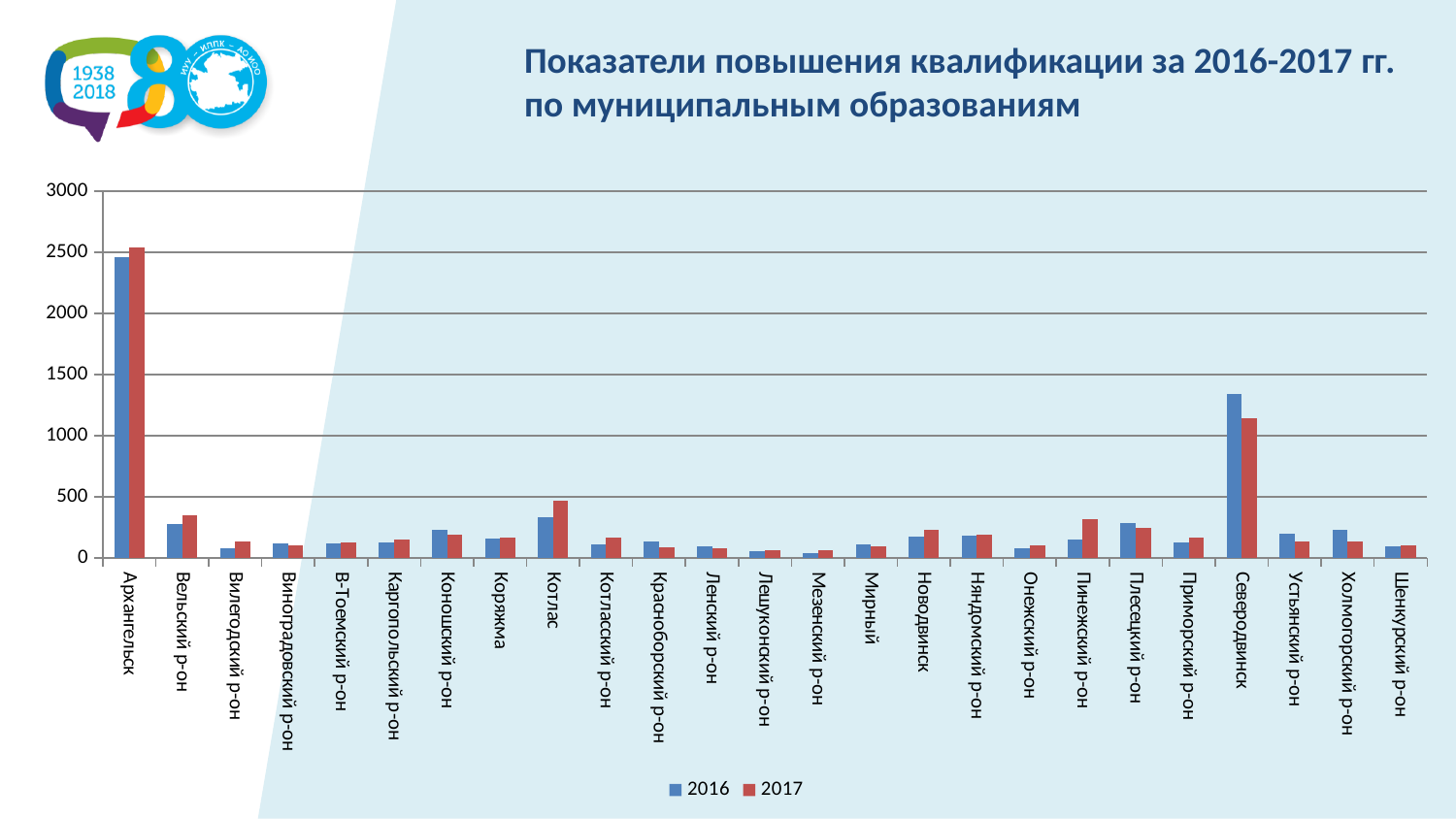
Which years are listed in the legend? 2016 and 2017 What kind of chart is shown on the slide? bar chart Is the 2017 value for Вельский р-он greater or less than 500? less Which colour represents the 2017 series? red Is the 2016 value for Северодвинск greater or less than 1000? greater How many series does the legend list? 2 How many municipalities (categories) are shown on the x axis? 25 Is the 2016 value for Архангельск greater or less than 2000? greater For Северодвинск, which year has the larger value, 2016 or 2017? 2016 Which municipality has the highest value for 2016? Архангельск Which municipality has the highest value for 2017? Архангельск For Пинежский р-он, which year has the larger value, 2016 or 2017? 2017